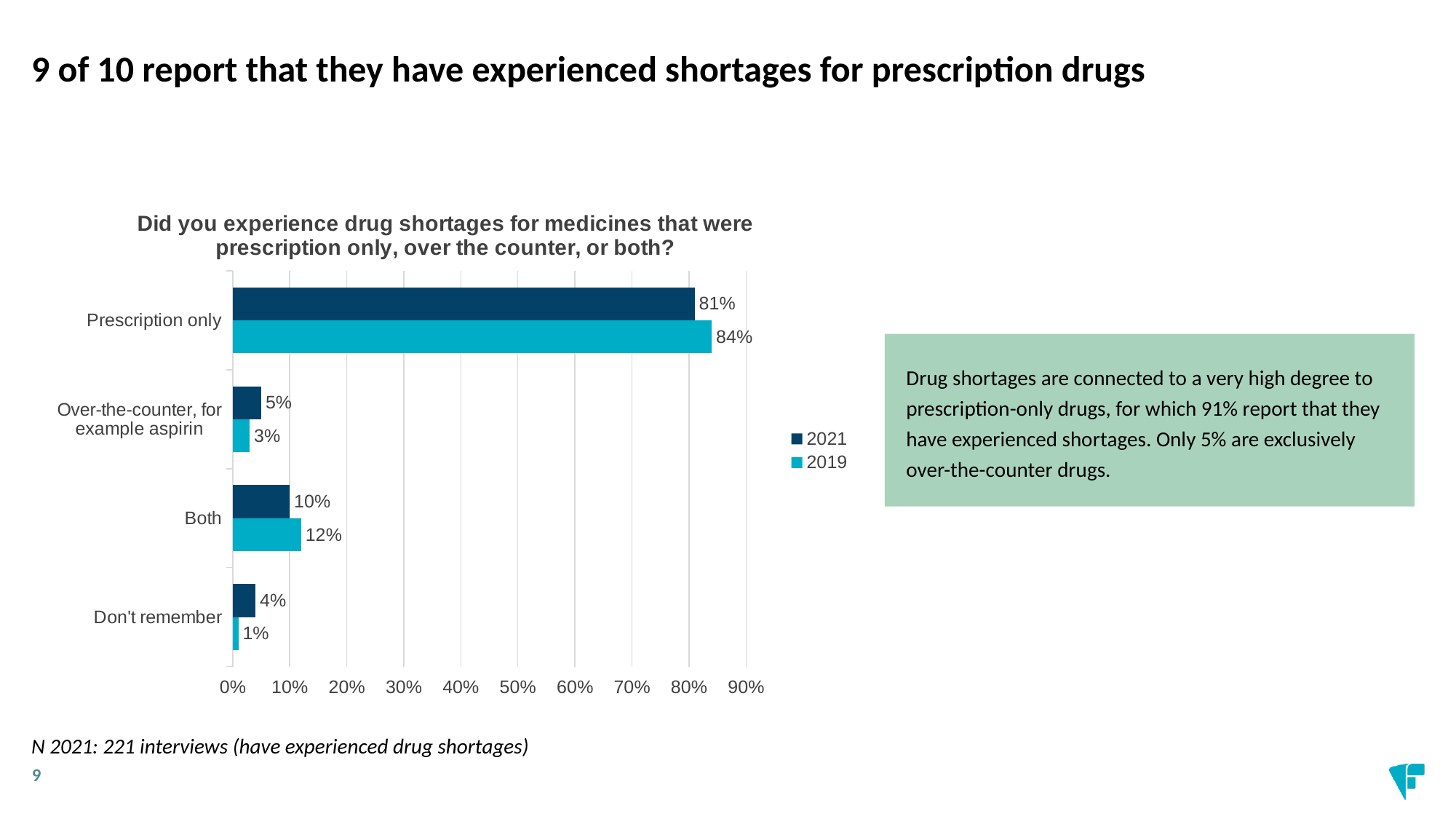
How many categories are shown on the chart? 4 What is the 2019 value for Both? 12% Which is larger for Both: the 2021 value or the 2019 value? 2019 How many series does the legend list? 2 What is the 2019 value for Over-the-counter, for example aspirin? 3% Which category has the lowest 2021 value? Don't remember What is the 2021 value for Don't remember? 4% Which category has the highest 2019 value? Prescription only What kind of chart is shown on the slide? Bar chart What is the title of the chart? Did you experience drug shortages for medicines that were prescription only, over the counter, or both? What is the difference between the 2019 and 2021 values for Prescription only? 3% What is the 2021 value for Prescription only? 81%